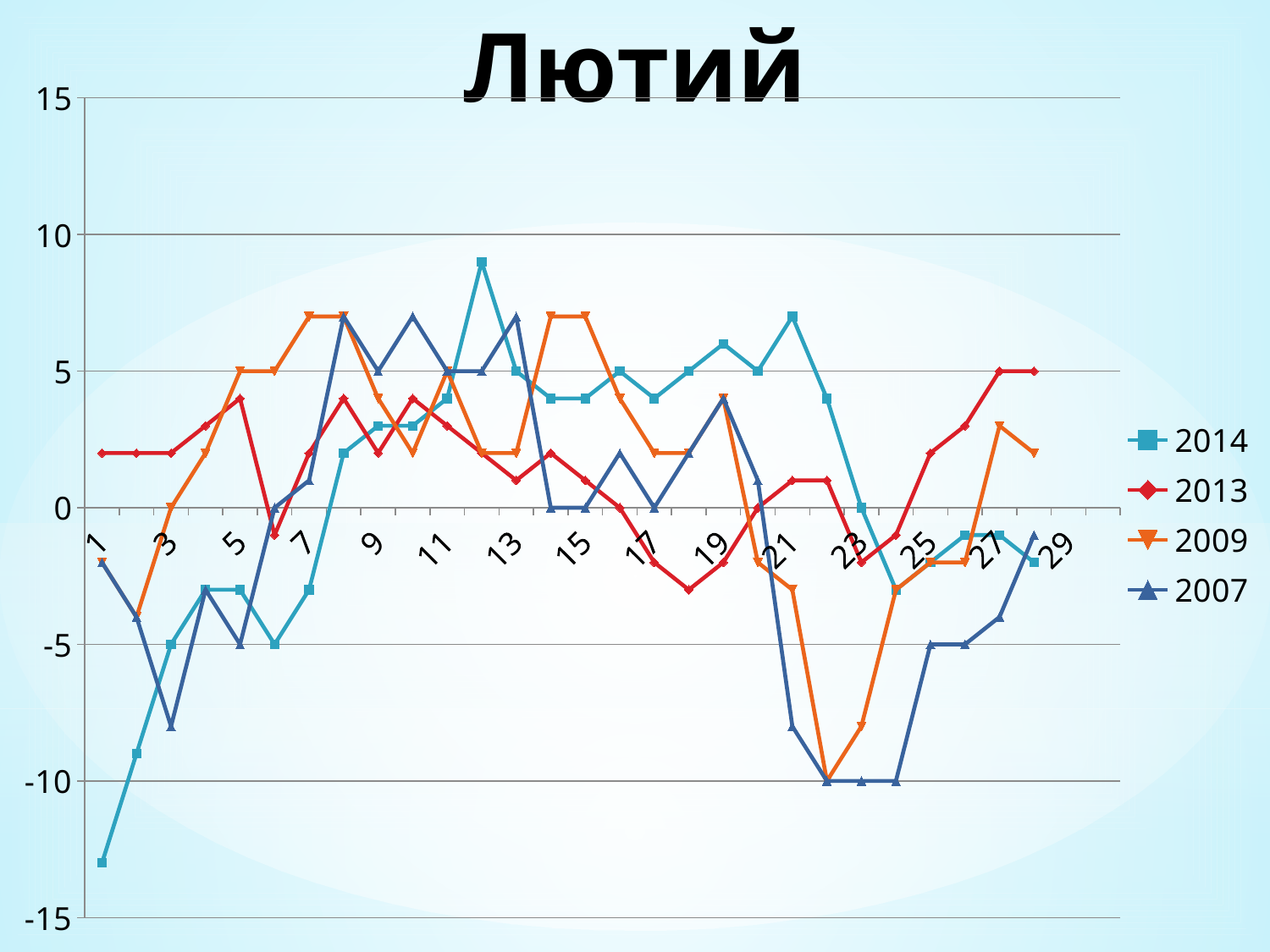
Is the value for 2013 on day 17 greater or less than 0? less On day 1, which series has the larger value, 2014 or 2013? 2013 Is the value for 2009 on day 7 greater or less than 5? greater How many series does the legend list? 4 Is the value for 2007 on day 3 greater or less than -5? less Which series reaches the lowest value anywhere on the chart? 2014 What is the title of the chart? Лютий What kind of chart is shown on the slide? line chart On day 21, which series has the larger value, 2014 or 2007? 2014 Which series is drawn with square markers? 2014